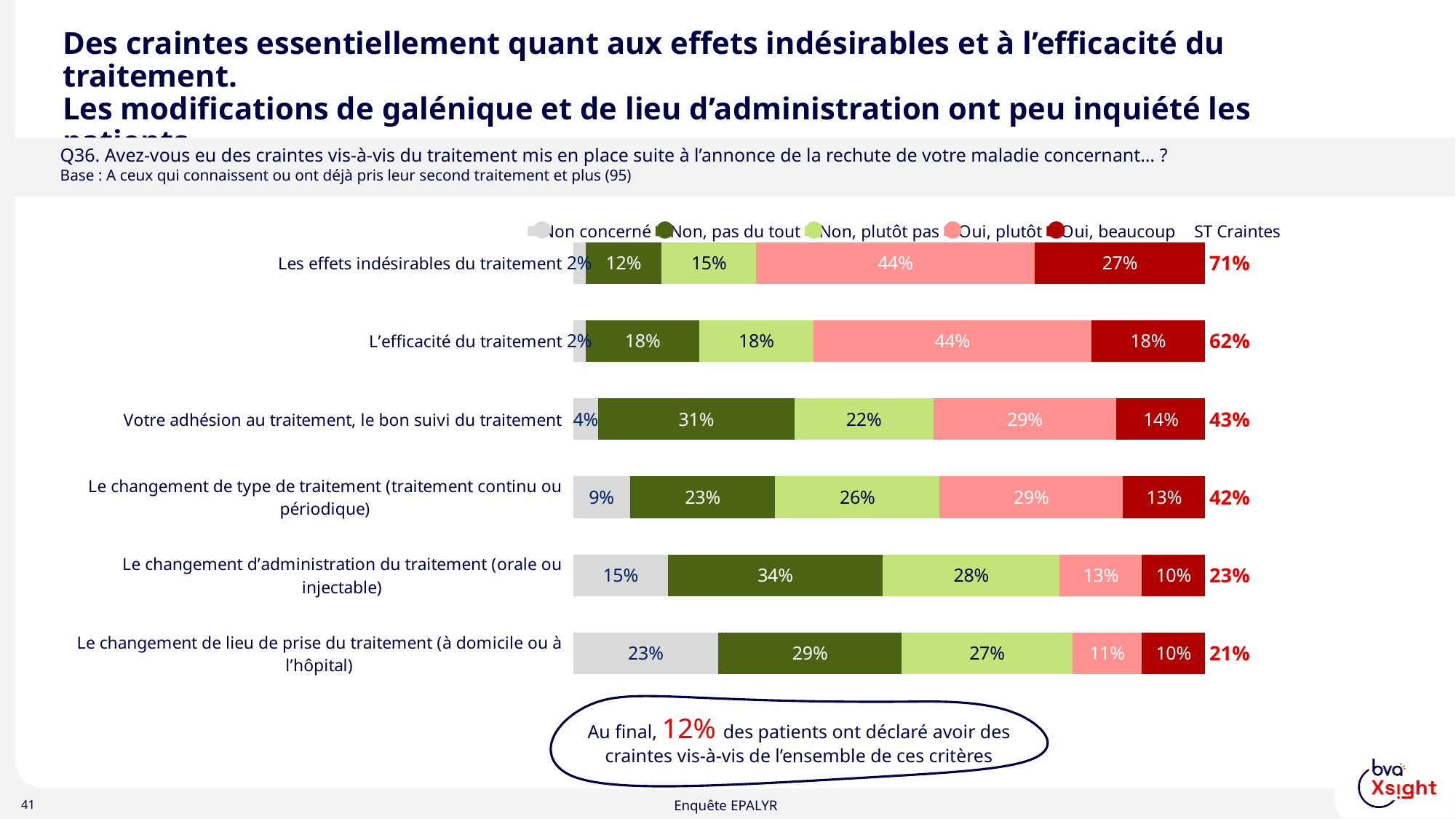
How many categories (rows) are plotted in the chart? 6 What kind of chart is shown on the slide? stacked bar chart What is the 'Non concerné' value for 'Le changement de lieu de prise du traitement (à domicile ou à l'hôpital)'? 23% Which is larger: the 'Non, plutôt pas' value for 'Le changement de type de traitement (traitement continu ou périodique)' or for 'L'efficacité du traitement'? Le changement de type de traitement (traitement continu ou périodique) What is the difference between the 'Oui, plutôt' values for 'Les effets indésirables du traitement' and 'Votre adhésion au traitement, le bon suivi du traitement'? 15% What is the 'Non, pas du tout' value for 'Le changement d'administration du traitement (orale ou injectable)'? 34% How many series does the chart legend list? 5 What is the ST Craintes value for 'L'efficacité du traitement'? 62% Which category has the lowest ST Craintes value? Le changement de lieu de prise du traitement (à domicile ou à l'hôpital) What is the 'Oui, beaucoup' value for 'Les effets indésirables du traitement'? 27% Which category has the highest ST Craintes value? Les effets indésirables du traitement What colour represents the 'Oui, beaucoup' series in the chart? dark red